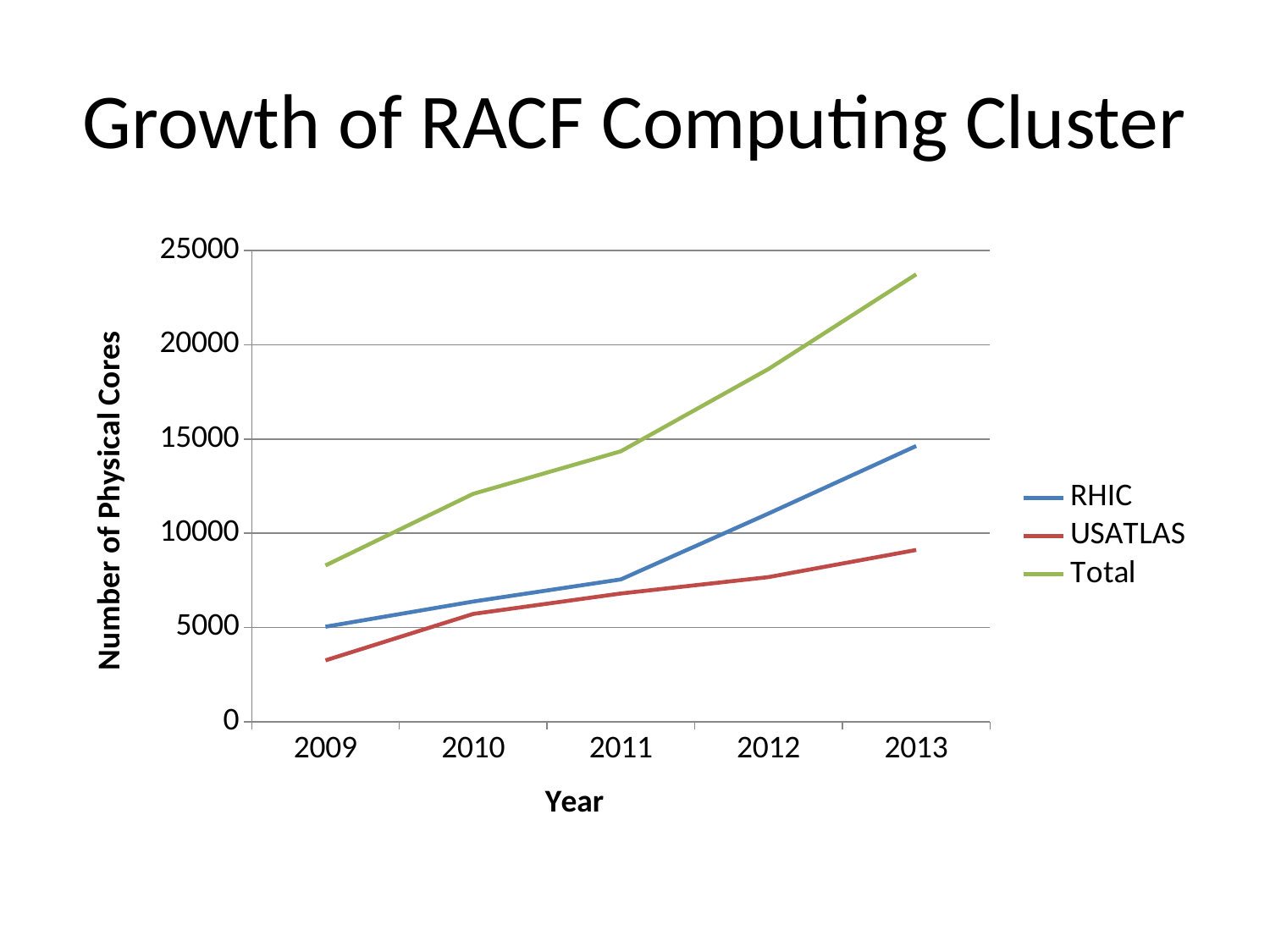
Is the value for RHIC in 2011 greater or less than 10000? less Is the value for Total in 2009 greater or less than 10000? less Is the value for USATLAS in 2013 greater or less than 10000? less Does the Total series rise or fall from 2009 to 2013? rise How many series does the legend list? 3 What is the label of the y axis? Number of Physical Cores Which is larger in 2012, RHIC or USATLAS? RHIC How many years are plotted along the x axis? 5 What kind of chart is shown on the slide? line chart Which series has the lowest value in 2009? USATLAS Which series has the highest value in 2013? Total